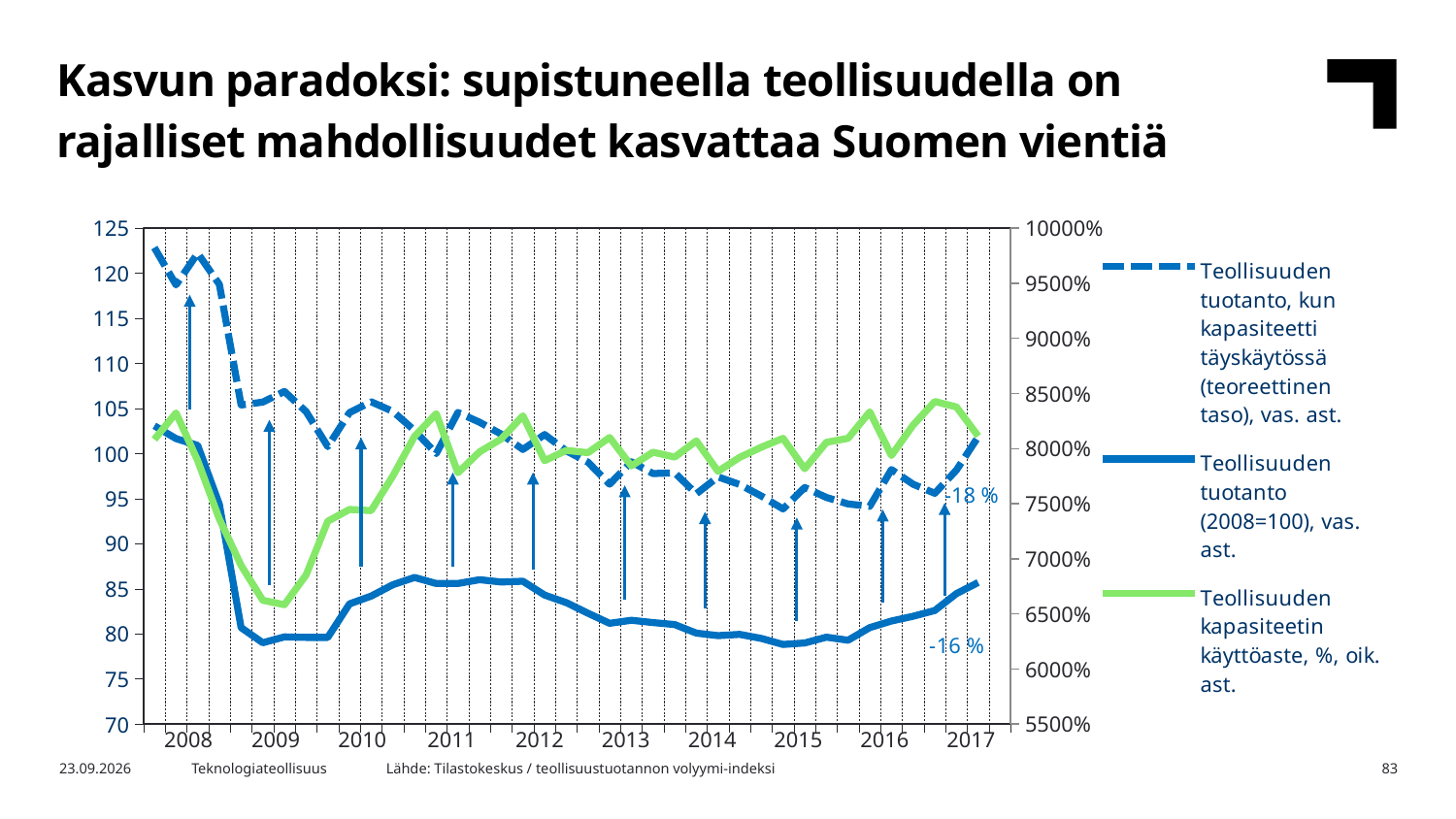
Is the value of the solid blue line (Teollisuuden tuotanto, 2008=100) at the end of 2017 greater or less than 90? less Does the dashed line (Teollisuuden tuotanto, kun kapasiteetti täyskäytössä) rise or fall overall from 2008 to 2017? fall Is the value of the dashed line (Teollisuuden tuotanto, kun kapasiteetti täyskäytössä) at the start of 2008 greater or less than 120? greater How many series does the legend list? 3 In which year does the dashed line (Teollisuuden tuotanto, kun kapasiteetti täyskäytössä) reach its highest value? 2008 Is the value of the solid blue line (Teollisuuden tuotanto, 2008=100) in 2009 greater or less than 85? less Which series is drawn as a dashed line? Teollisuuden tuotanto, kun kapasiteetti täyskäytössä (teoreettinen taso), vas. ast. What kind of chart is shown on the slide? line chart Does the solid blue line (Teollisuuden tuotanto, 2008=100) rise or fall between 2008 and 2009? fall In 2009, which is higher on the left axis: the dashed line (theoretical full-capacity production) or the solid blue line (Teollisuuden tuotanto, 2008=100)? the dashed line What percentage annotation is printed near the end of the solid blue line (Teollisuuden tuotanto, 2008=100)? -16 % How many year labels are shown on the x axis? 10